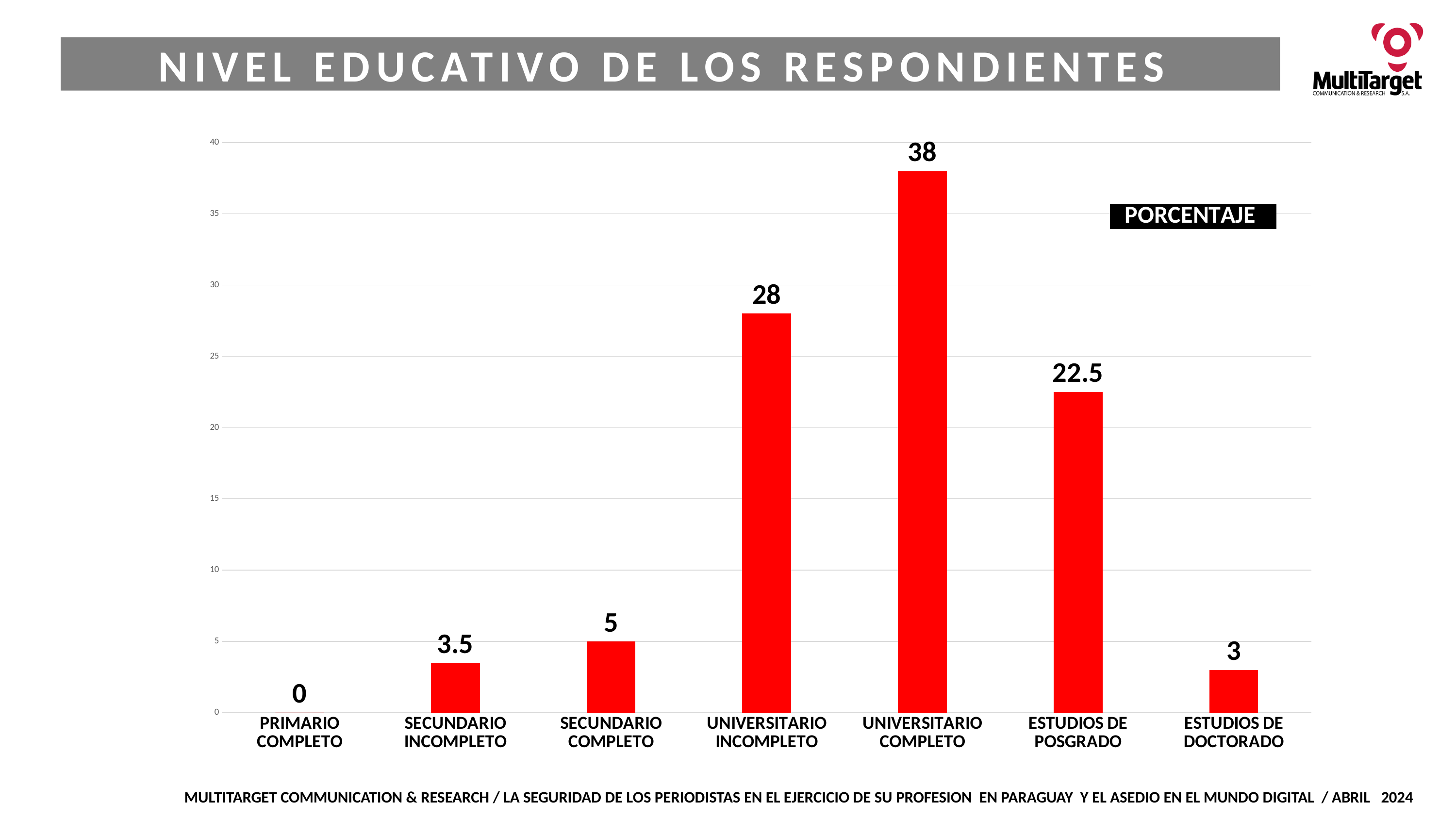
What is the difference between the values for UNIVERSITARIO COMPLETO and UNIVERSITARIO INCOMPLETO? 10 How many categories are shown on the x axis? 7 Which is larger, the value for SECUNDARIO COMPLETO or the value for ESTUDIOS DE DOCTORADO? SECUNDARIO COMPLETO What is the value for ESTUDIOS DE DOCTORADO? 3 What is the title of the slide? NIVEL EDUCATIVO DE LOS RESPONDIENTES Which category has the lowest value? PRIMARIO COMPLETO What is the value for SECUNDARIO INCOMPLETO? 3.5 Which category has the highest value? UNIVERSITARIO COMPLETO Is the value for ESTUDIOS DE POSGRADO greater or less than 20? greater What is the value for UNIVERSITARIO COMPLETO? 38 What is the value for ESTUDIOS DE POSGRADO? 22.5 What kind of chart is shown on the slide? bar chart